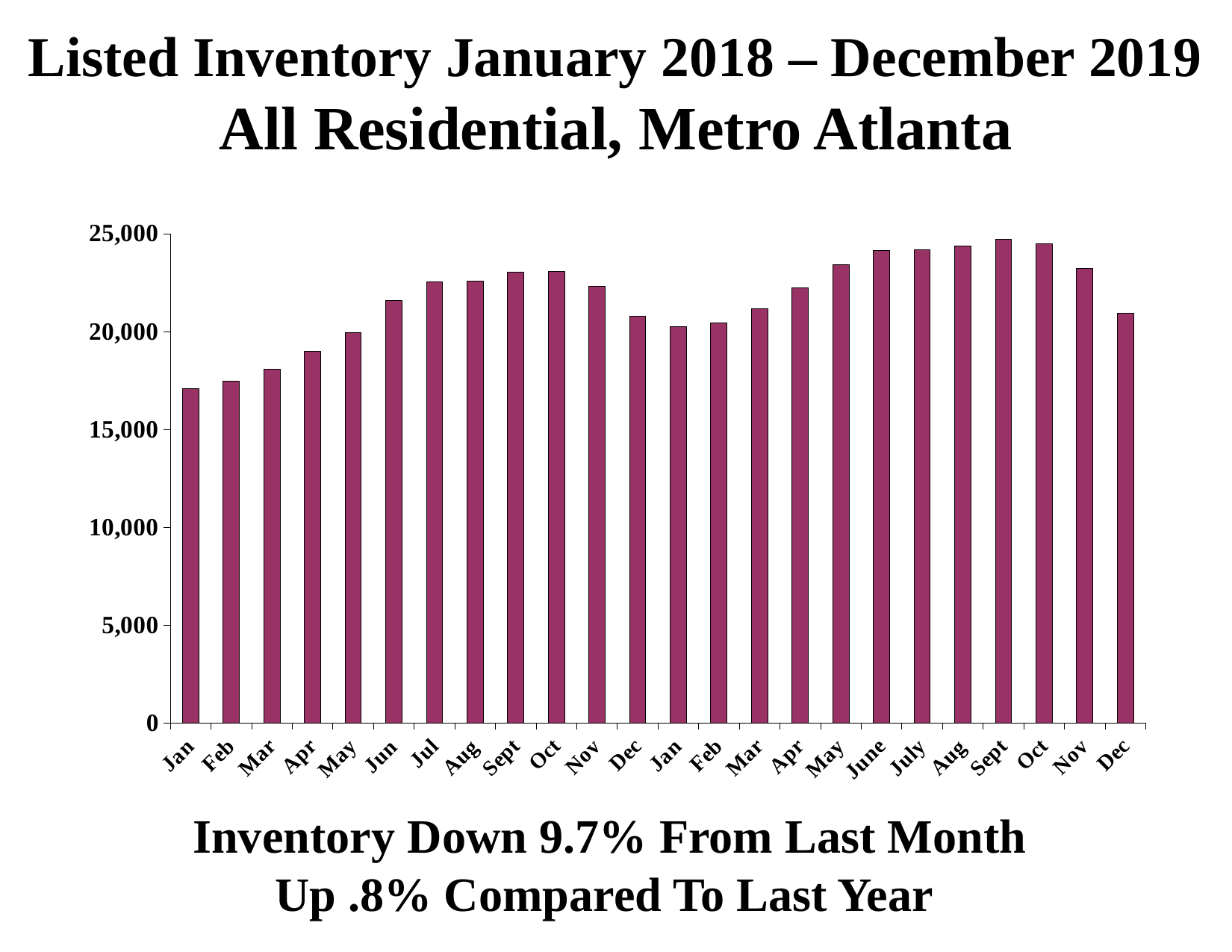
Is the value for the second Sept bar (September 2019) greater or less than 25,000? less Is the value for the first Feb bar (February 2018) greater or less than 20,000? less What kind of chart is shown on the slide? bar chart According to the text below the chart, by what percentage is inventory down from last month? 9.7% Which month has the lowest listed inventory in the chart? Jan (2018, the first bar) Which is larger, the first Mar bar (March 2018) or the second Mar bar (March 2019)? Mar 2019 Is the value for the first Sept bar (September 2018) greater or less than 20,000? greater Which is larger, the first Oct bar (October 2018) or the second Oct bar (October 2019)? Oct 2019 Do the values rise or fall from the first Jan bar (January 2018) through the first Oct bar (October 2018)? rise How many bars (months) are plotted in the chart? 24